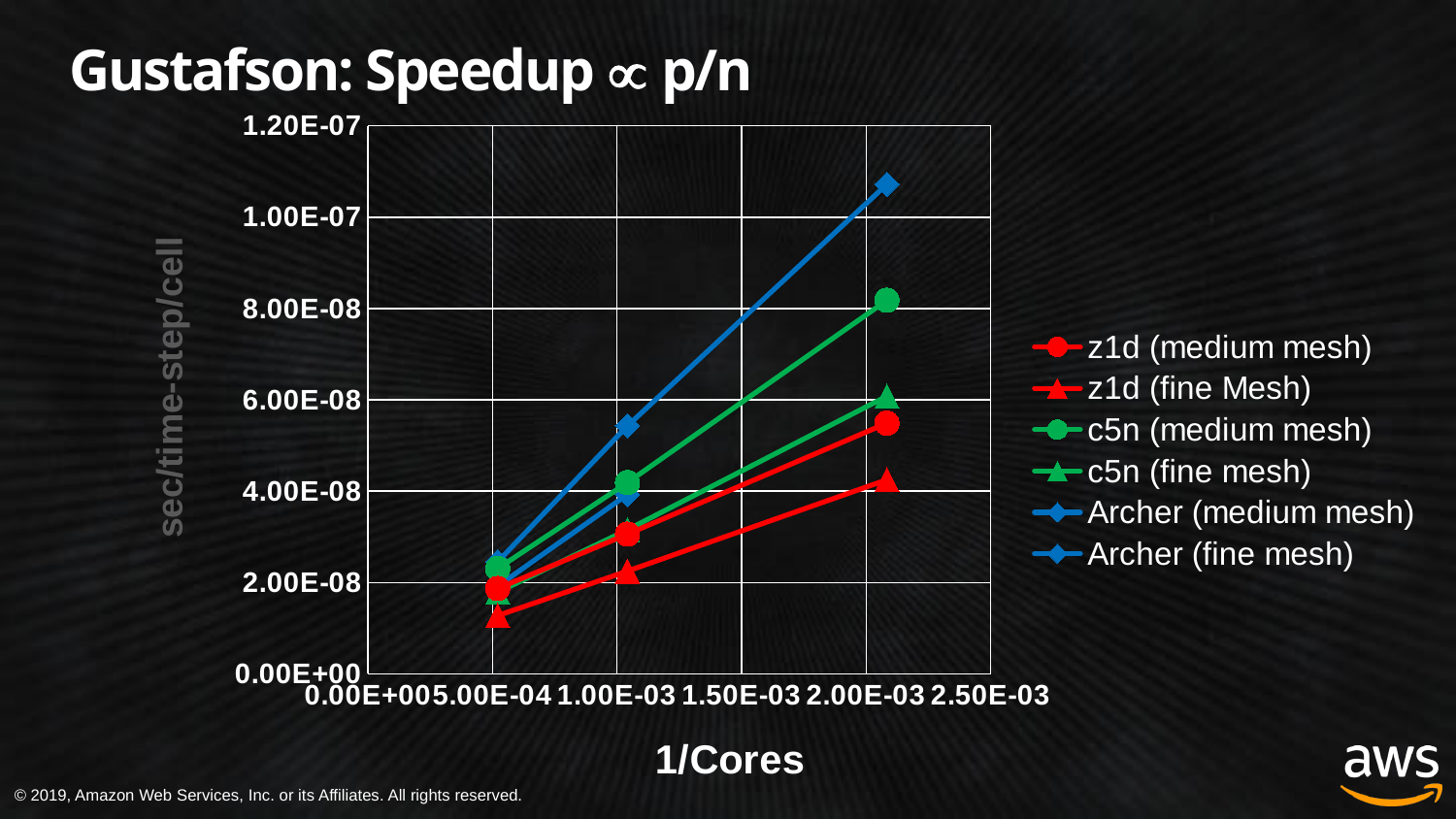
Which series has the lowest value at 1/Cores = 2.00E-03? z1d (fine Mesh) What is the title of the x axis? 1/Cores At 1/Cores = 2.00E-03, which is larger: c5n (medium mesh) or z1d (medium mesh)? c5n (medium mesh) What is the title of the y axis? sec/time-step/cell Is the value for z1d (fine Mesh) at 1/Cores = 2.00E-03 greater or less than 6.00E-08? less Is the value for c5n (medium mesh) at 1/Cores = 2.00E-03 greater or less than 1.00E-07? less How many series does the legend list? 6 Is the value for z1d (medium mesh) at 1/Cores = 2.00E-03 greater or less than 6.00E-08? less What kind of chart is shown on the slide? line chart